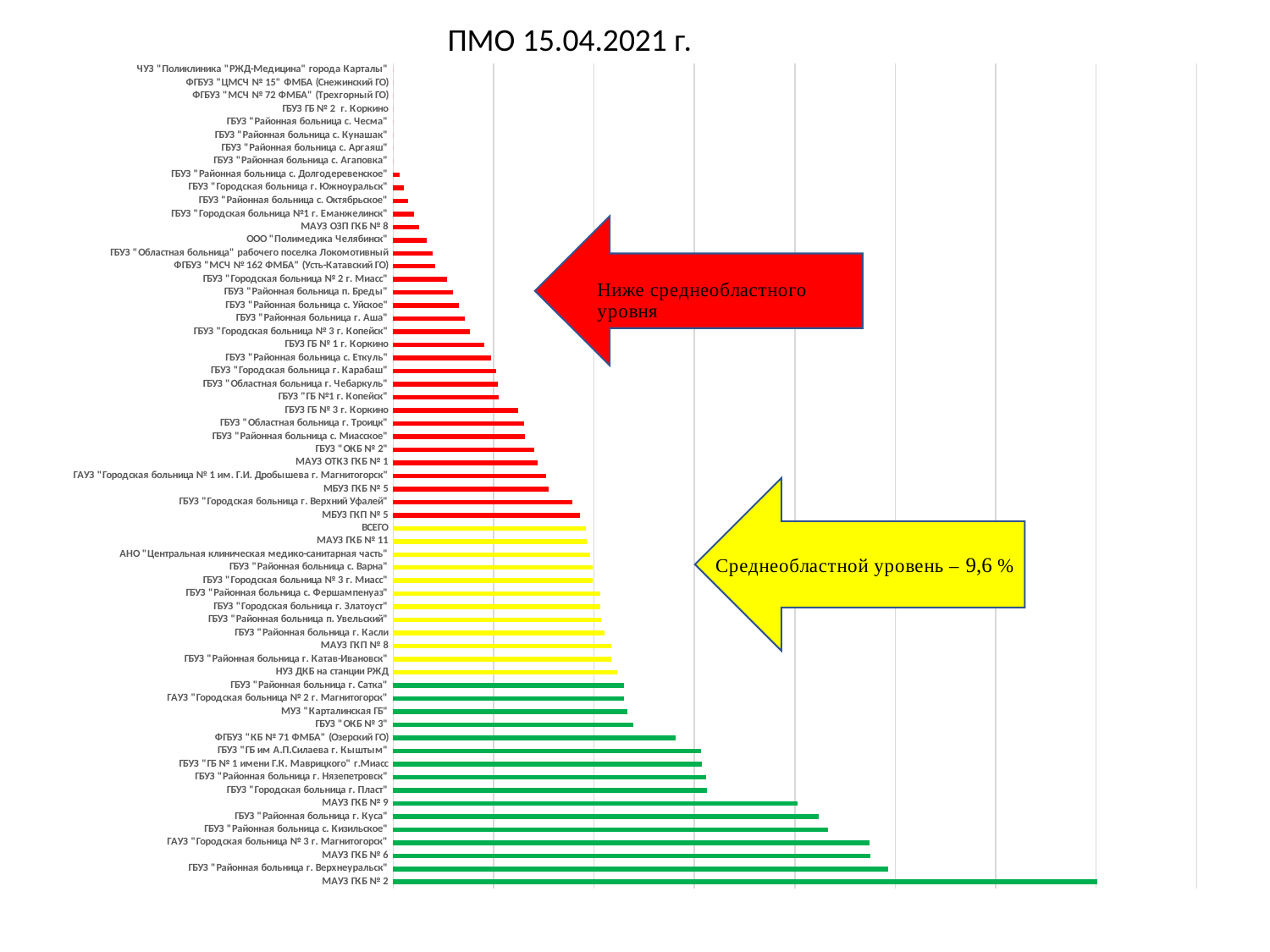
Do the bars get longer or shorter going from the top of the chart to the bottom? longer What regional average level (среднеобластной уровень) is stated on the slide? 9,6 % Which has the longer bar: МАУЗ ГКБ № 2 or ГБУЗ "Районная больница г. Верхнеуральск"? МАУЗ ГКБ № 2 Which has the longer bar: ФГБУЗ "КБ № 71 ФМБА" (Озерский ГО) or ГБУЗ "ОКБ № 3"? ФГБУЗ "КБ № 71 ФМБА" (Озерский ГО) Which has the longer bar: ГБУЗ "ГБ им А.П.Силаева г. Кыштым" or ГБУЗ "Районная больница с. Миасское"? ГБУЗ "ГБ им А.П.Силаева г. Кыштым" What is the title of the chart? ПМО 15.04.2021 г. What kind of chart is shown on the slide? bar chart Which category has the longest bar? МАУЗ ГКБ № 2 How many bars are coloured green? 16